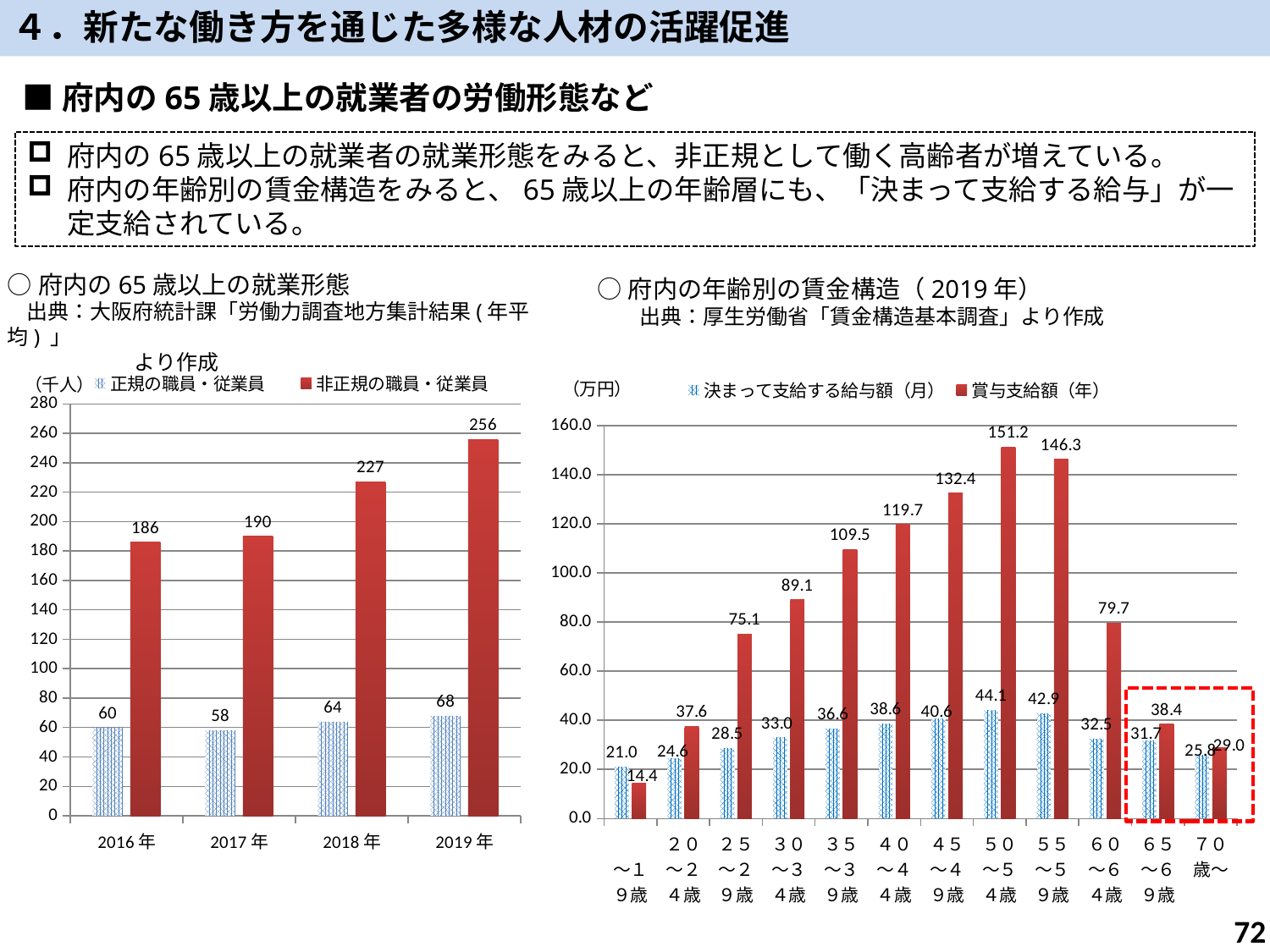
In the left chart (府内の65歳以上の就業形態), does the value for 非正規の職員・従業員 rise or fall from 2016年 to 2019年? rise In the right chart (府内の年齢別の賃金構造), which is larger for 70歳～: 決まって支給する給与額（月） or 賞与支給額（年）? 賞与支給額（年） In the left chart (府内の65歳以上の就業形態), what is the difference between the 非正規の職員・従業員 values for 2019年 and 2016年? 70 In the left chart (府内の65歳以上の就業形態), what is the value for 正規の職員・従業員 in 2017年? 58 In the right chart (府内の年齢別の賃金構造), which age group has the lowest value of 賞与支給額（年）? ～19歳 In the left chart (府内の65歳以上の就業形態), how many series does the legend list? 2 In the right chart (府内の年齢別の賃金構造), what is the value of 賞与支給額（年） for 50～54歳? 151.2 In the right chart (府内の年齢別の賃金構造), what is the value of 決まって支給する給与額（月） for 65～69歳? 31.7 In the right chart (府内の年齢別の賃金構造), how many age groups are shown on the x axis? 12 In the left chart (府内の65歳以上の就業形態), what is the value for 非正規の職員・従業員 in 2019年? 256 In the left chart (府内の65歳以上の就業形態), which year has the highest value for 非正規の職員・従業員? 2019年 What kind of chart is the right chart (府内の年齢別の賃金構造)? bar chart